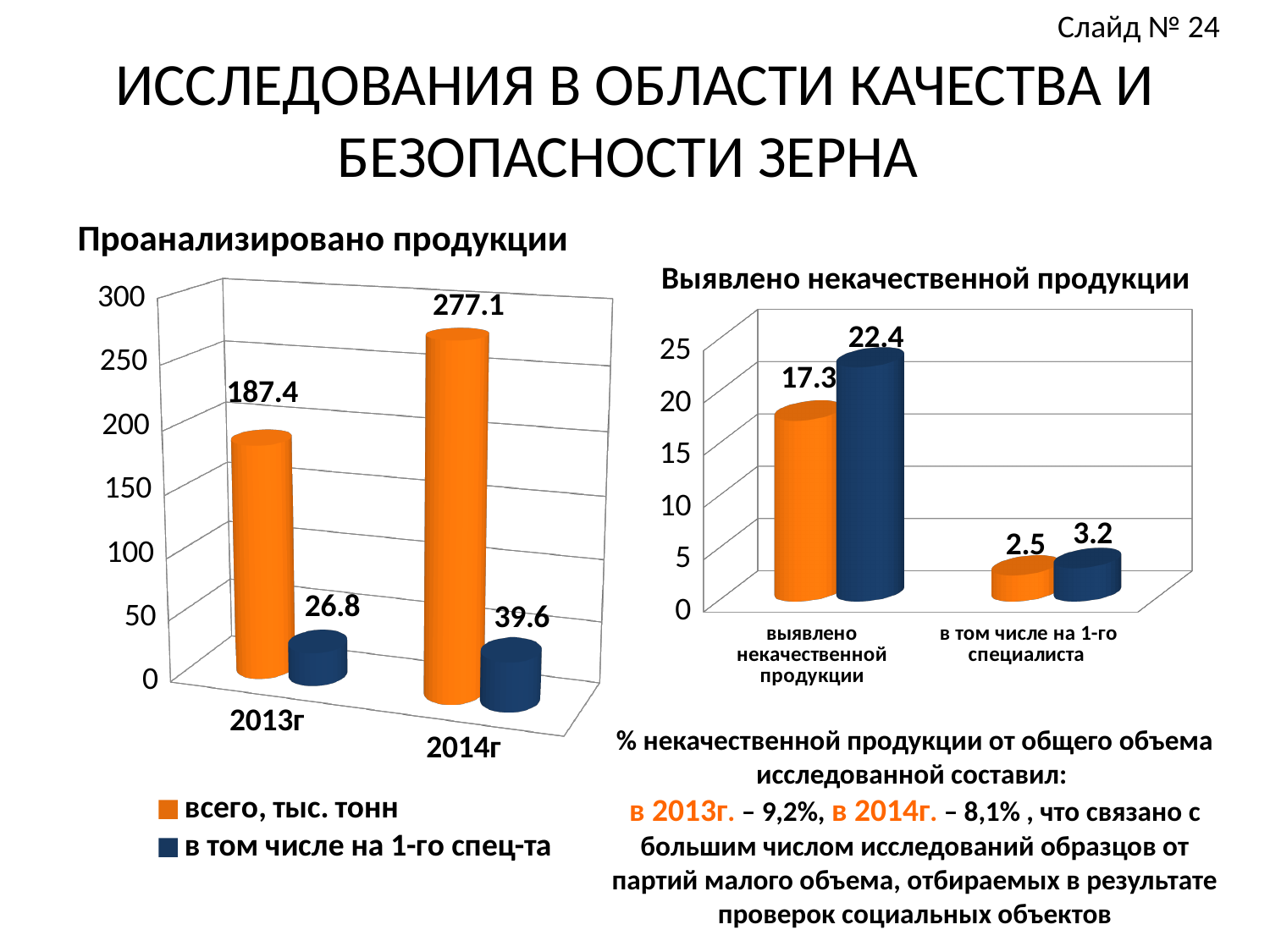
In the chart 'Проанализировано продукции', by how much did 'всего, тыс. тонн' increase from 2013г to 2014г? 89.7 In the chart 'Выявлено некачественной продукции', what is the value of the blue bar for 'в том числе на 1-го специалиста'? 3.2 In the chart 'Выявлено некачественной продукции', how many categories are shown on the x axis? 2 In the chart 'Проанализировано продукции', how many series does the legend list? 2 What type of chart is 'Проанализировано продукции'? bar chart In the chart 'Проанализировано продукции', what is the value of 'всего, тыс. тонн' for 2014г? 277.1 In the chart 'Выявлено некачественной продукции', what is the difference between the blue and orange bars for 'выявлено некачественной продукции'? 5.1 In the chart 'Выявлено некачественной продукции', which bar is the highest? the blue bar for 'выявлено некачественной продукции' (22.4) In the chart 'Проанализировано продукции', does the value of 'всего, тыс. тонн' rise or fall from 2013г to 2014г? rise In the chart 'Выявлено некачественной продукции', what is the value of the orange bar for 'выявлено некачественной продукции'? 17.3 In the chart 'Проанализировано продукции', which year has the higher value for 'в том числе на 1-го спец-та'? 2014г In the chart 'Проанализировано продукции', what is the value of 'в том числе на 1-го спец-та' for 2013г? 26.8